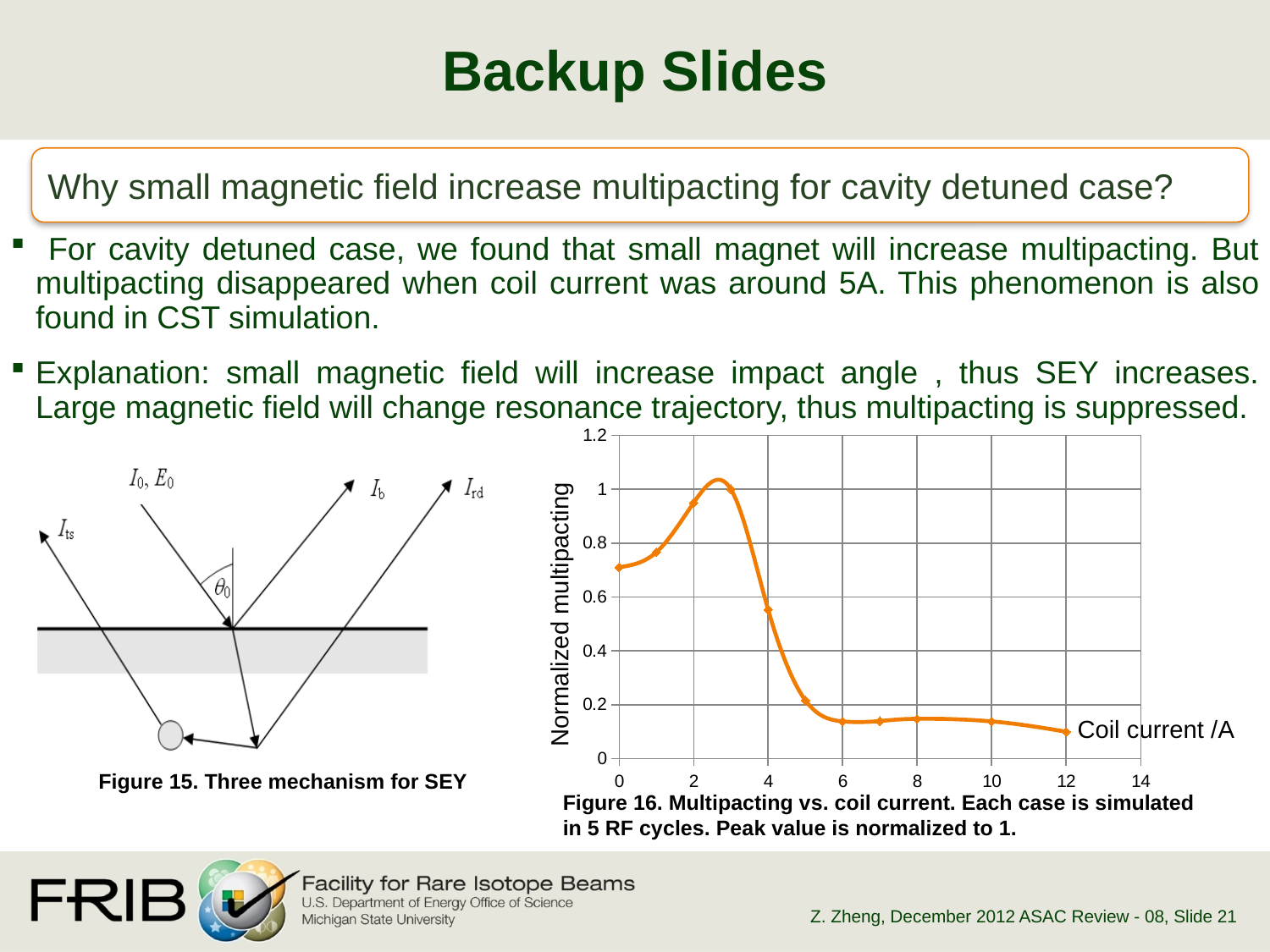
In Figure 16, is the normalized multipacting at a coil current of 4 A greater or less than 0.4? greater In Figure 16, at which coil current does the normalized multipacting reach its highest value? 3 A In Figure 16, is the normalized multipacting at a coil current of 6 A greater or less than 0.2? less What quantity is plotted on the horizontal axis of Figure 16? Coil current /A What kind of chart is Figure 16? line chart In Figure 16, is the normalized multipacting at a coil current of 2 A greater or less than 0.8? greater What is the label of the vertical axis in Figure 16? Normalized multipacting In Figure 16, which has higher normalized multipacting: a coil current of 0 A or 5 A? 0 A In Figure 16, which has higher normalized multipacting: a coil current of 2 A or 6 A? 2 A In Figure 16, does the normalized multipacting rise or fall as the coil current increases from 4 A to 6 A? fall